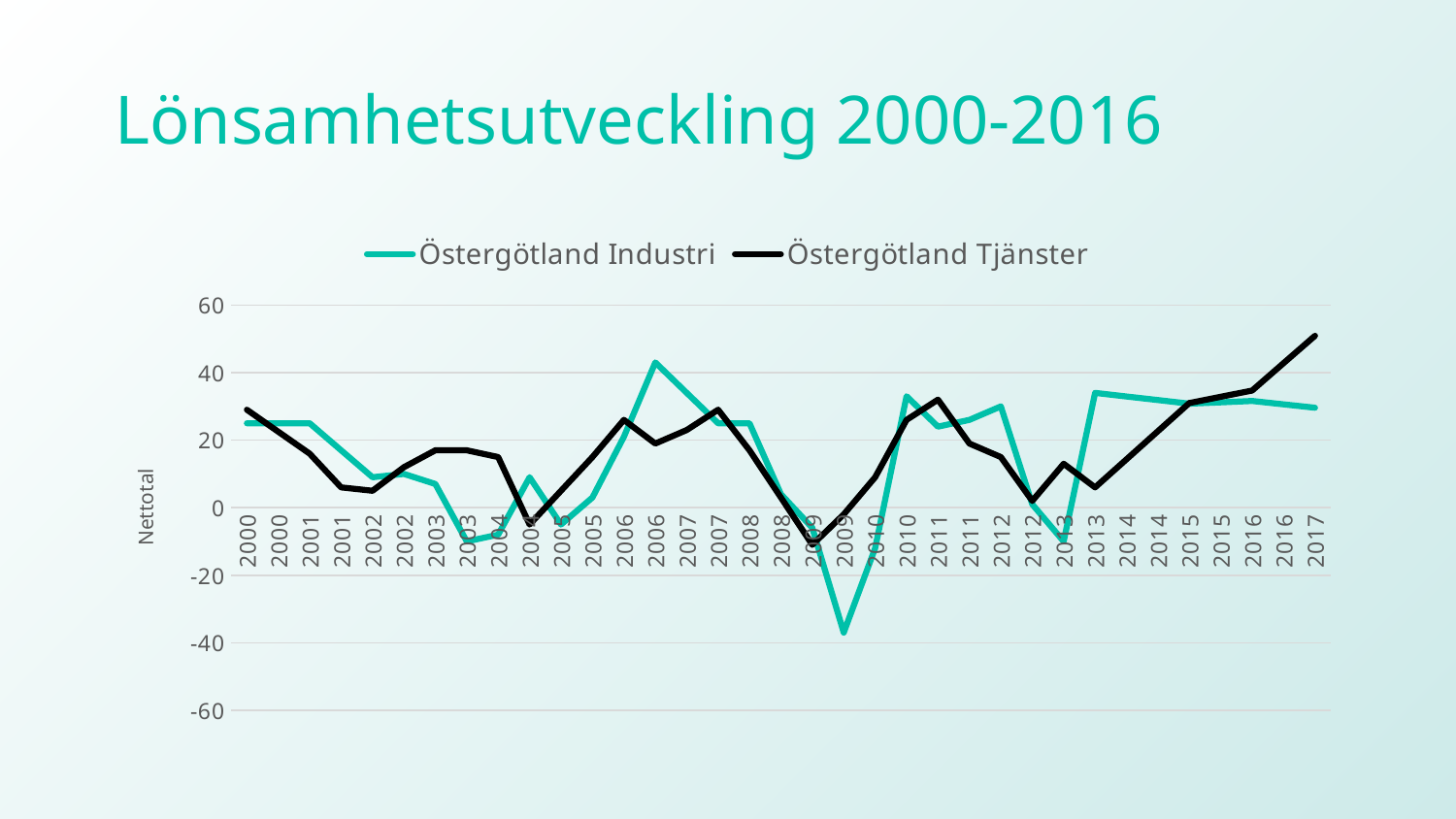
Is the peak value for Östergötland Industri at 2006 greater or less than 40? greater In which year does Östergötland Industri reach its lowest value? 2009 What kind of chart is shown on the slide? Line chart In which year does Östergötland Tjänster reach its highest value? 2017 Does the Östergötland Tjänster line rise or fall from 2013 to 2017? Rise What is the label on the vertical axis? Nettotal How many series does the legend list? 2 Is the value for Östergötland Tjänster at 2017 greater or less than 40? greater Is the lowest value for Östergötland Industri, at 2009, greater or less than -20? less At 2017, which series has the higher value, Östergötland Industri or Östergötland Tjänster? Östergötland Tjänster What is the title of the chart on the slide? Lönsamhetsutveckling 2000-2016